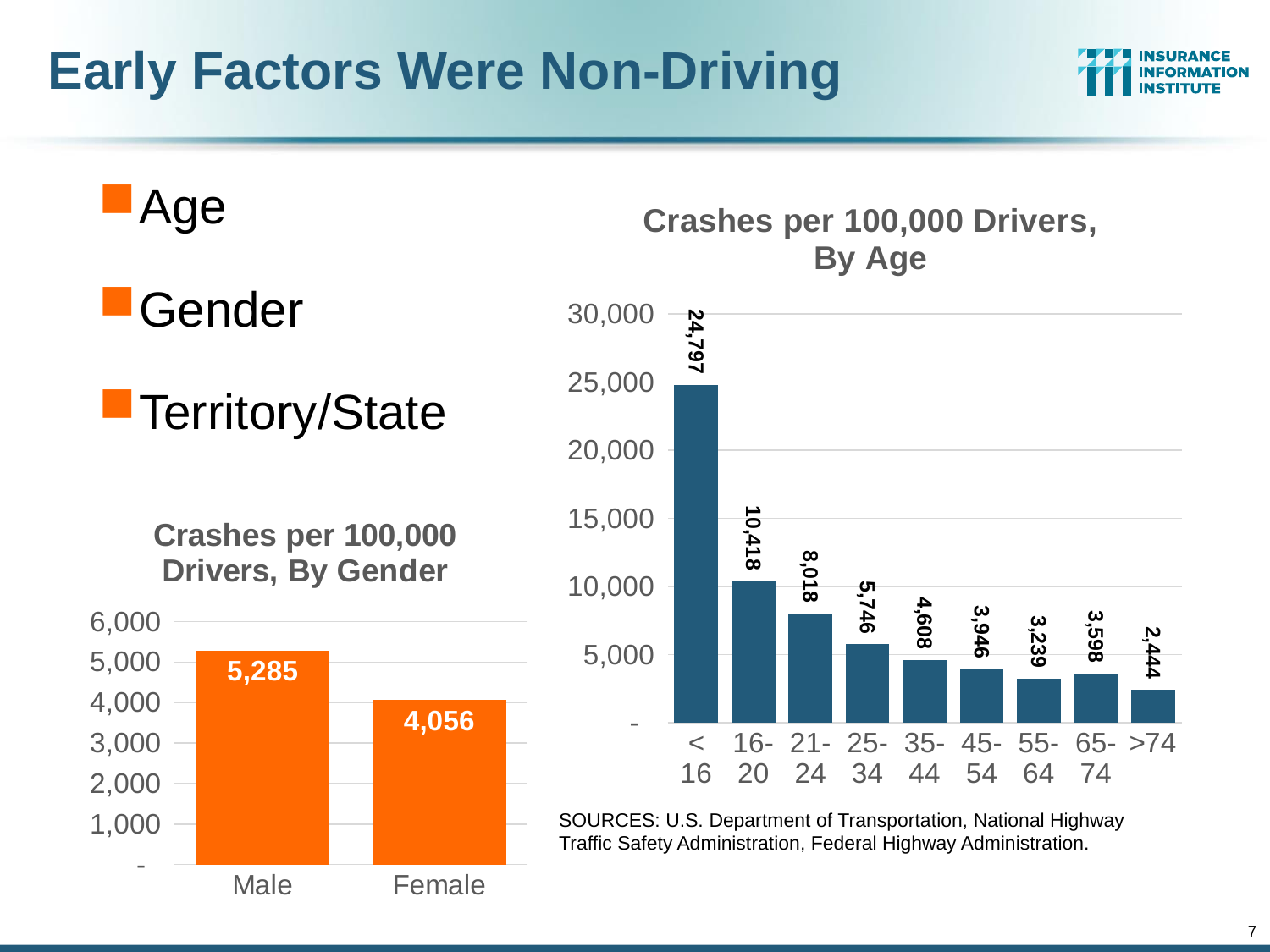
In the 'Crashes per 100,000 Drivers, By Gender' chart, what is the value for Male? 5,285 In the 'Crashes per 100,000 Drivers, By Gender' chart, how many categories are shown? 2 What kind of chart is the 'Crashes per 100,000 Drivers, By Age' chart? Bar chart In the 'Crashes per 100,000 Drivers, By Gender' chart, what is the value for Female? 4,056 In the 'Crashes per 100,000 Drivers, By Age' chart, which is larger: the value for 55-64 or the value for 65-74? 65-74 In the 'Crashes per 100,000 Drivers, By Age' chart, what is the value for the 16-20 age group? 10,418 In the 'Crashes per 100,000 Drivers, By Age' chart, what is the value for the >74 age group? 2,444 In the 'Crashes per 100,000 Drivers, By Age' chart, which age group has the highest value? < 16 In the 'Crashes per 100,000 Drivers, By Age' chart, what is the difference between the values for < 16 and 16-20? 14,379 In the 'Crashes per 100,000 Drivers, By Age' chart, how many age groups are shown? 9 In the 'Crashes per 100,000 Drivers, By Gender' chart, what is the difference between the Male and Female values? 1,229 In the 'Crashes per 100,000 Drivers, By Age' chart, which age group has the lowest value? >74